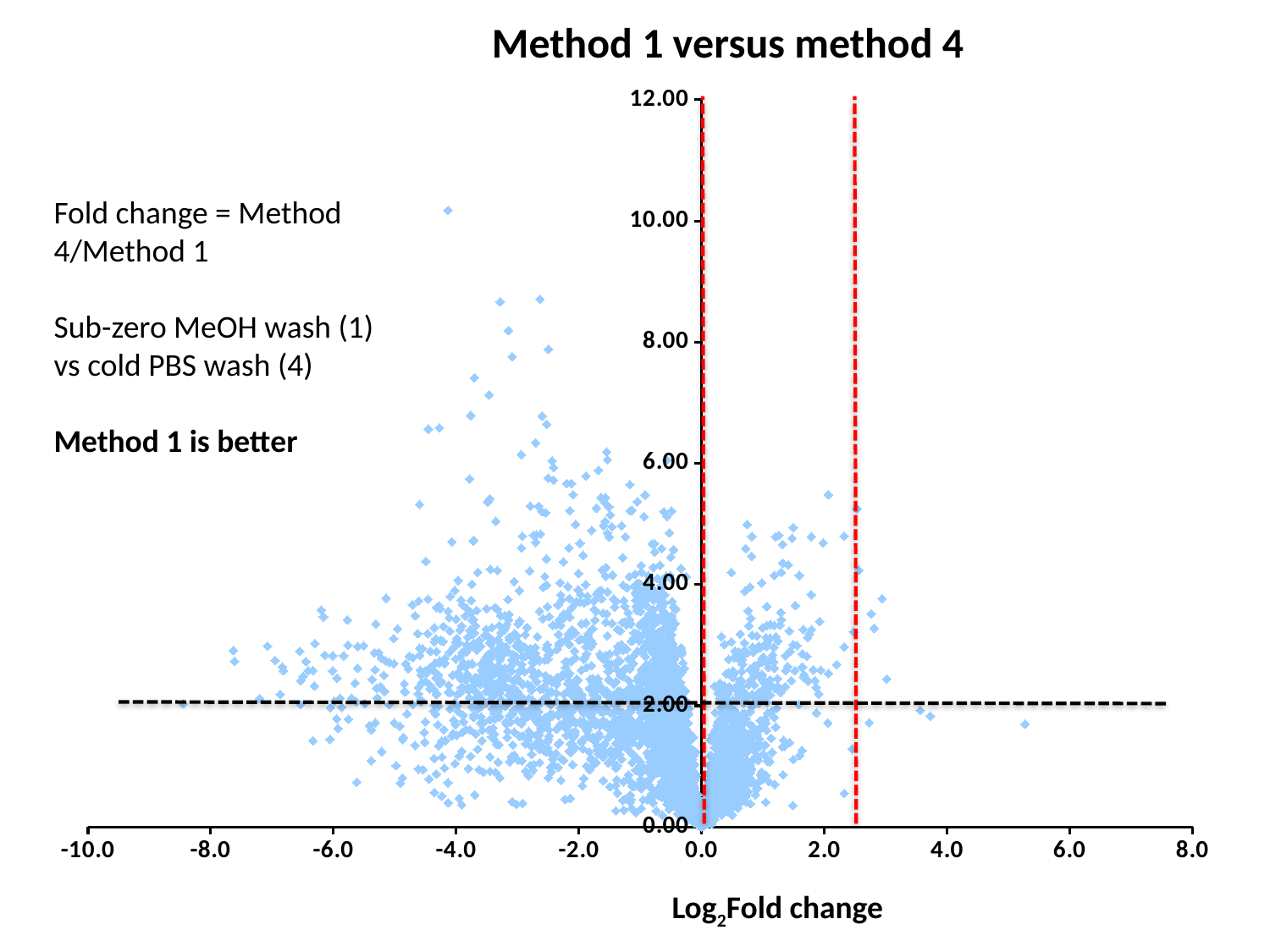
What kind of chart is shown on the slide? scatter chart At what y-axis value is the horizontal black dashed line drawn? 2.00 Is the y value of the highest point on the chart greater or less than 8.00? greater At what x-axis value is the left red dashed vertical line drawn? 0.0 Are there more points to the left or to the right of the x value 0.0? left Is the x value of the right red dashed vertical line greater or less than 2.0? greater Is the x value of the rightmost point greater or less than 6.0? less What is the label of the x axis? Log2Fold change What is the title of the chart? Method 1 versus method 4